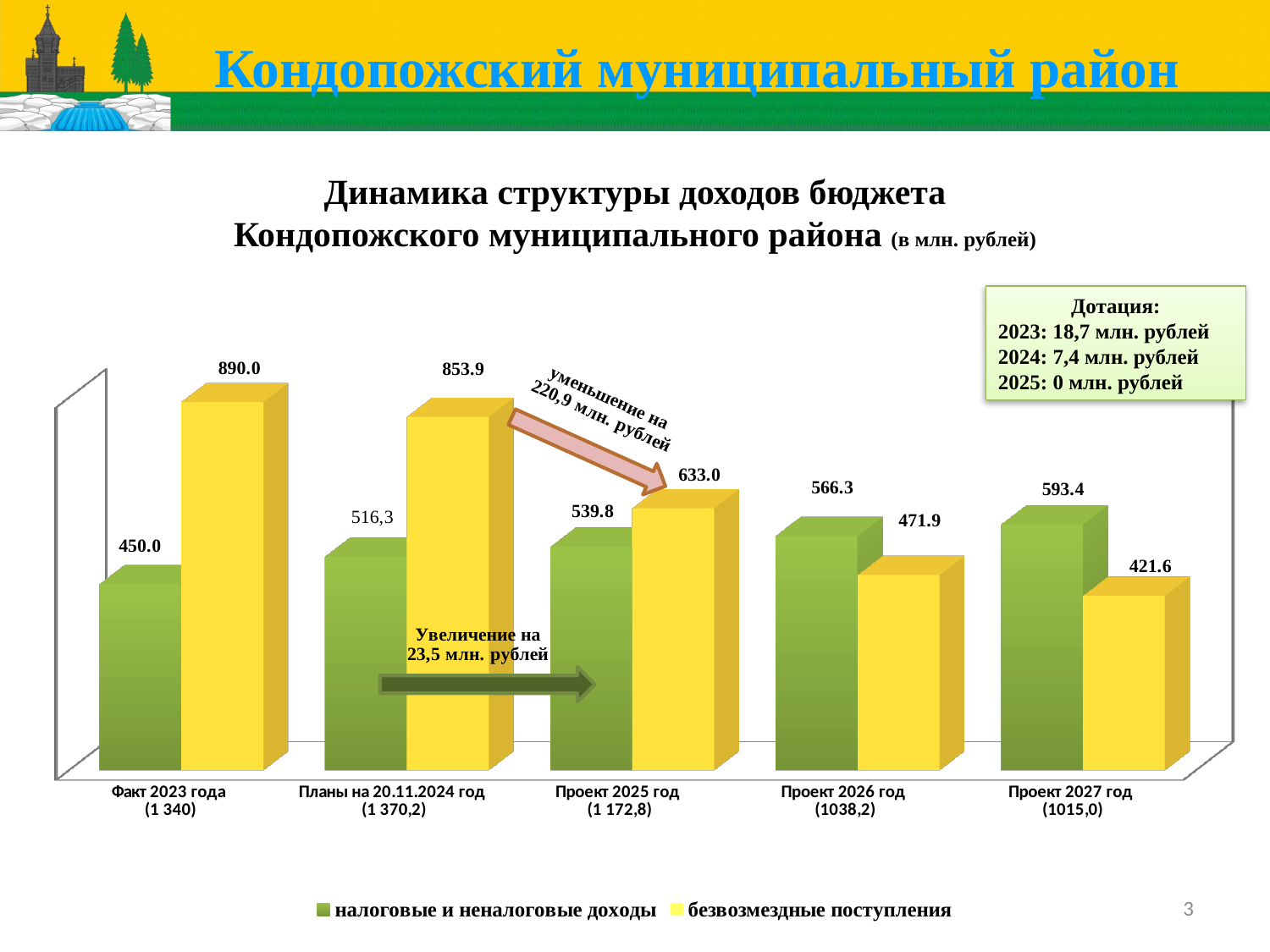
What is the value of безвозмездные поступления for Факт 2023 года? 890.0 What is the difference between безвозмездные поступления for Планы на 20.11.2024 год and Проект 2025 год? 220.9 What is the value of безвозмездные поступления for Проект 2025 год? 633.0 What type of chart is shown on the slide? bar chart How many series does the chart legend list? 2 Do the values for налоговые и неналоговые доходы rise or fall from left to right along the x axis? rise How many categories are shown along the x axis of the chart? 5 What is the value of налоговые и неналоговые доходы for Проект 2027 год? 593.4 For Проект 2026 год, which is larger: налоговые и неналоговые доходы or безвозмездные поступления? налоговые и неналоговые доходы Which category has the lowest value for налоговые и неналоговые доходы? Факт 2023 года Which category has the highest value for безвозмездные поступления? Факт 2023 года Which colour represents безвозмездные поступления in the chart? yellow